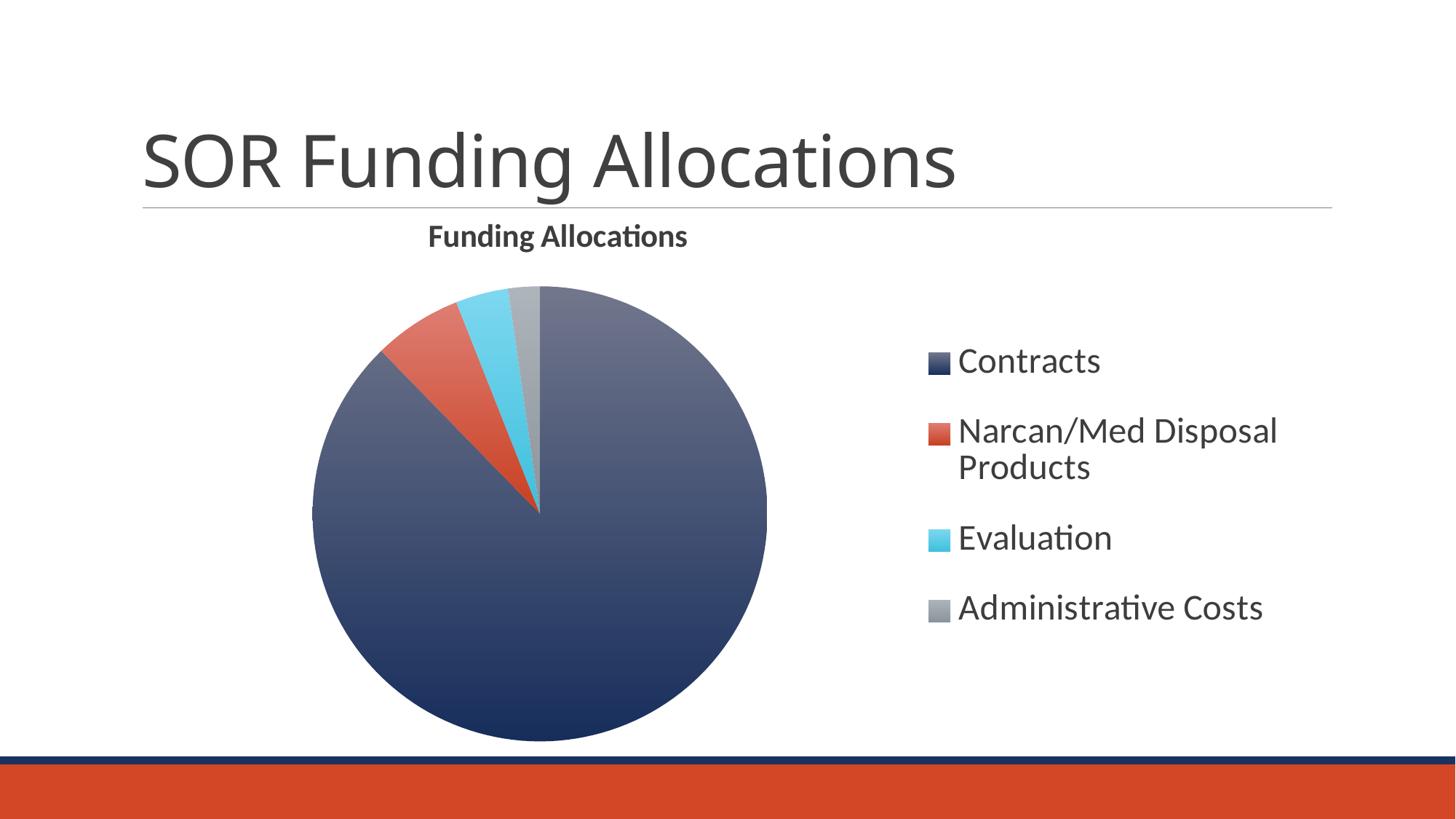
What kind of chart is shown on the slide? pie chart Does the Contracts slice take up more or less than half of the pie? more Which category has the smallest slice of the pie? Administrative Costs Which slice is larger, Evaluation or Administrative Costs? Evaluation Which category has the largest slice of the pie? Contracts What is the title of the chart? Funding Allocations Which slice is larger, Contracts or Narcan/Med Disposal Products? Contracts How many categories does the pie chart have? 4 Which category is shown in light blue in the pie chart? Evaluation